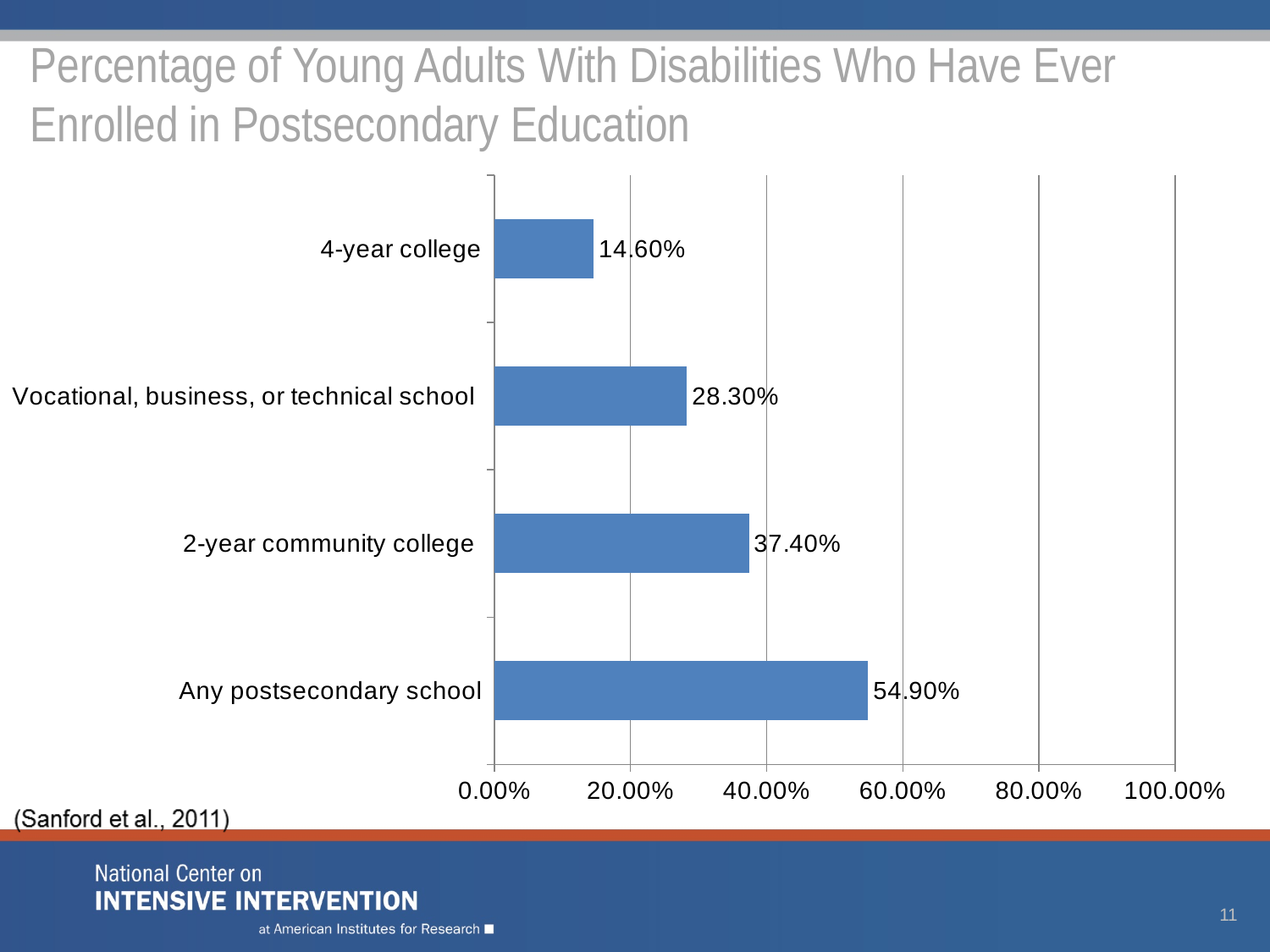
Is the value for Any postsecondary school greater or less than 60.00%? less How many categories are shown in the chart? 4 What percentage of young adults with disabilities have ever enrolled in a 4-year college? 14.60% What is the value shown for Any postsecondary school? 54.90% Which is larger: the value for 2-year community college or the value for Vocational, business, or technical school? 2-year community college What kind of chart is shown on the slide? Bar chart What is the value shown for 2-year community college? 37.40% Which category has the highest percentage? Any postsecondary school Which category has the lowest percentage? 4-year college What is the difference between the values for Any postsecondary school and 2-year community college? 17.50% What is the value shown for Vocational, business, or technical school? 28.30% What is the difference between the values for Vocational, business, or technical school and 4-year college? 13.70%